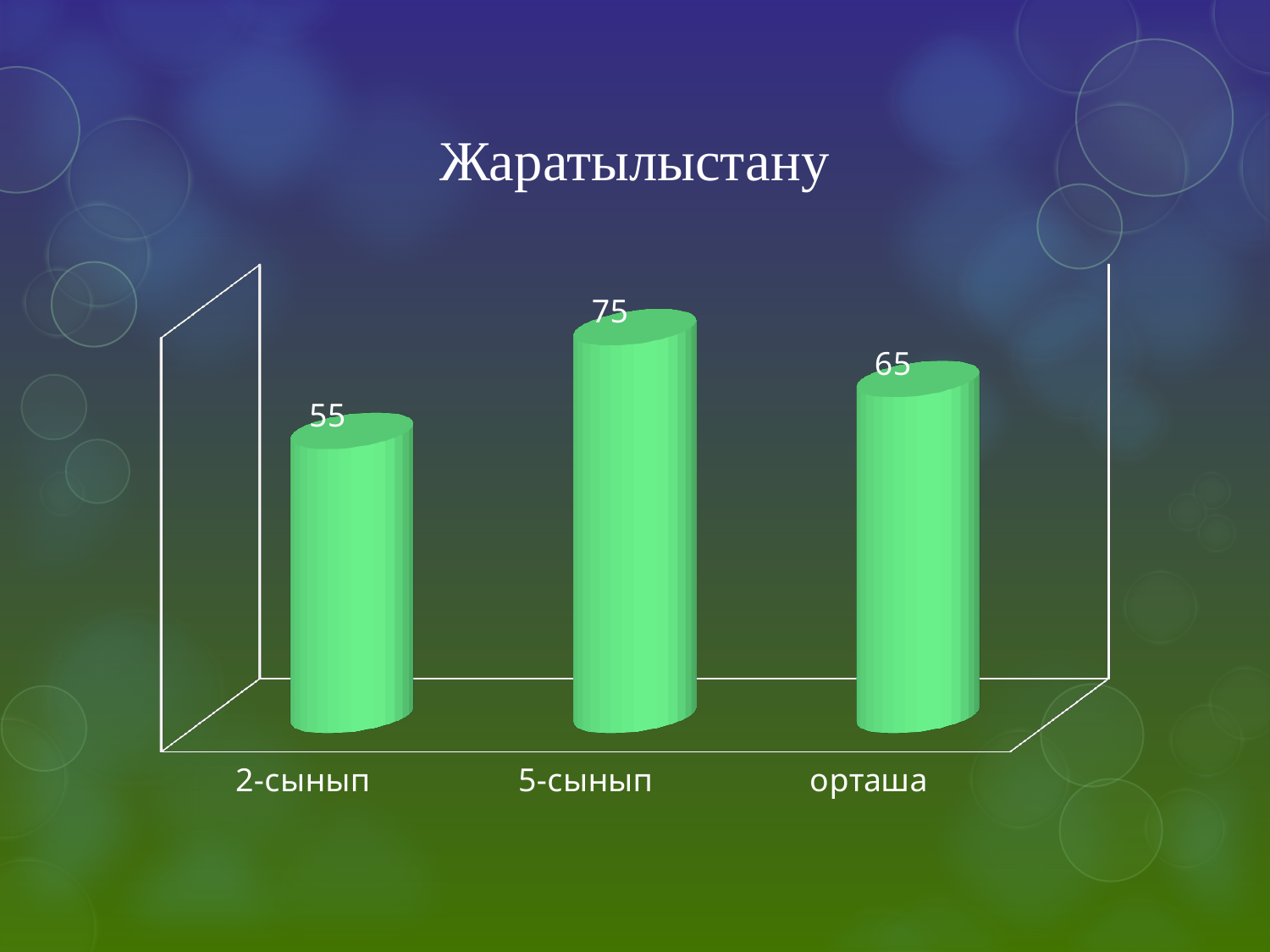
Which is larger, the value for 5-сынып or the value for орташа? 5-сынып How many categories are shown on the x axis? 3 Which category has the lowest value? 2-сынып What is the value for 5-сынып? 75 What is the title of the chart? Жаратылыстану What is the value for 2-сынып? 55 What colour are the bars in the chart? green Which category has the highest value? 5-сынып What is the difference between the values for 5-сынып and 2-сынып? 20 What kind of chart is shown on the slide? bar chart What is the difference between the values for орташа and 2-сынып? 10 What is the value for орташа? 65